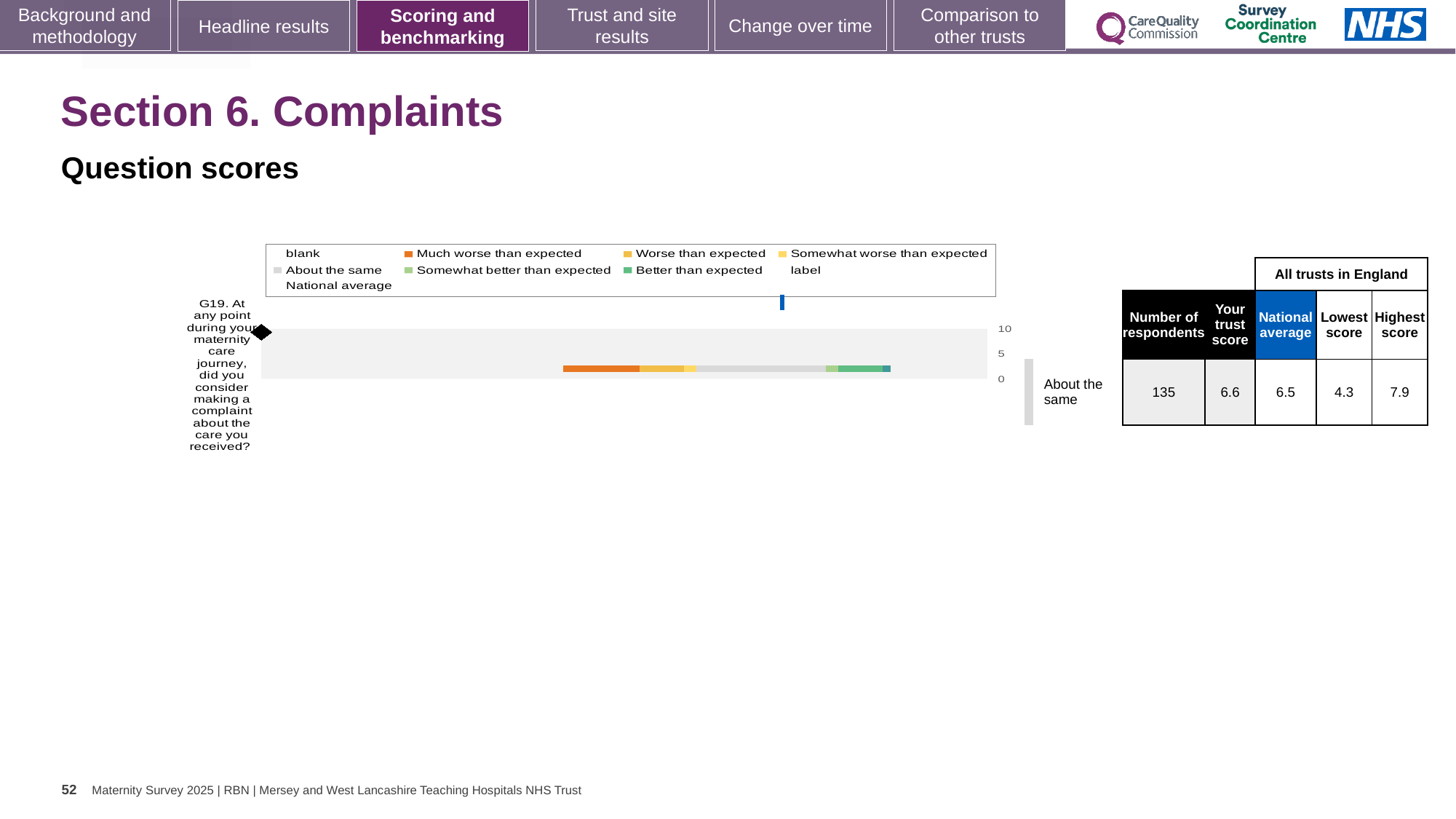
How many respondents answered question G19? 135 What is the national average for question G19 shown in the table next to the chart? 6.5 Which legend entry is shown in orange? Much worse than expected Which is larger for question G19: the trust score or the national average? trust score What is the trust score for question G19 shown in the table next to the chart? 6.6 What is the highest score among all trusts in England for question G19? 7.9 What kind of chart is shown on the slide for question G19? bar chart What is the highest tick value shown on the chart's axis? 10 What benchmark category is the trust's result for question G19 placed in? About the same How many questions (categories) are plotted in the chart? 1 What is the difference between the highest score and the lowest score for question G19? 3.6 What is the lowest score among all trusts in England for question G19? 4.3